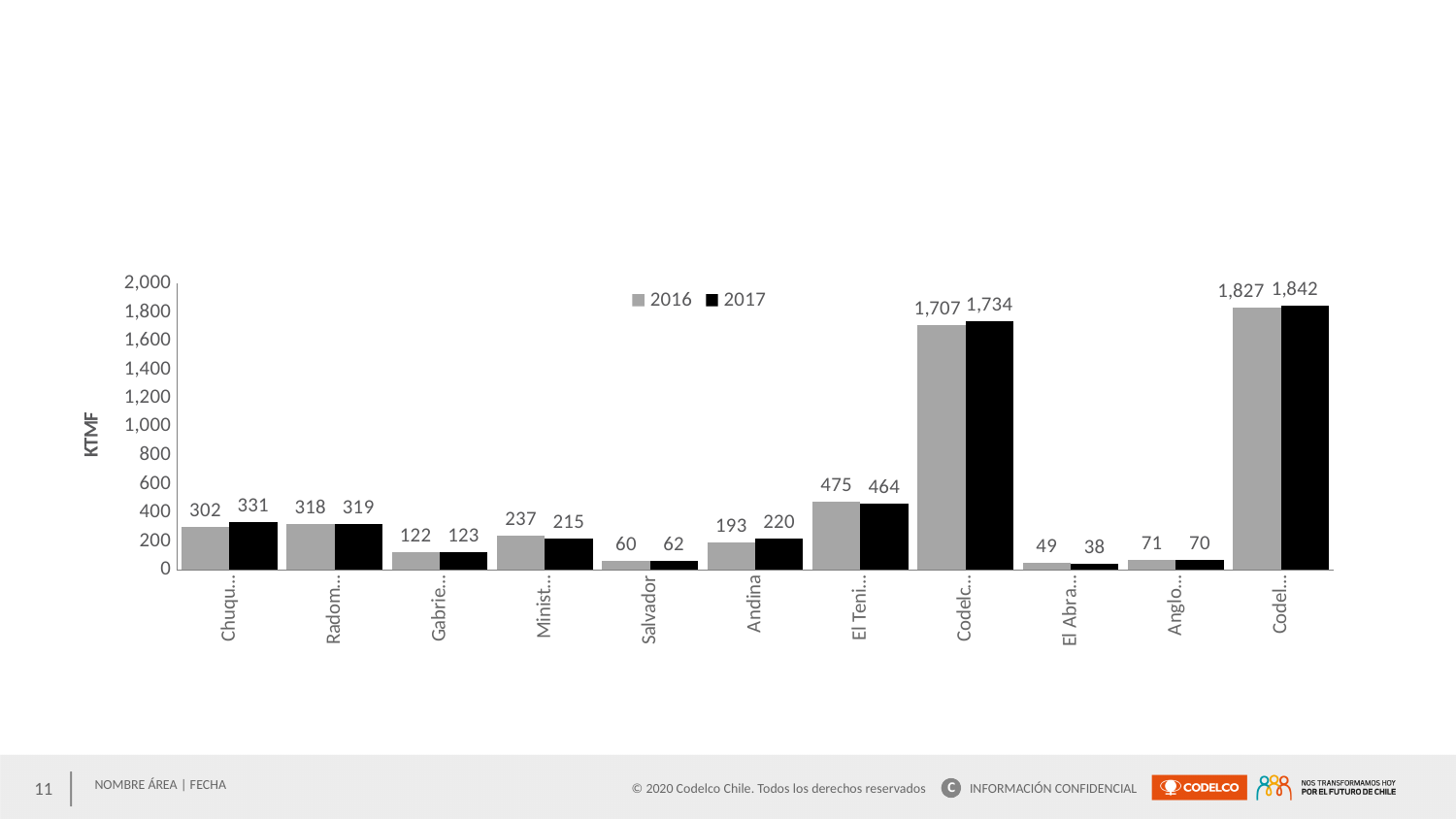
How many categories are shown on the x axis? 11 What is the 2016 value for Andina? 193 What is the 2017 value for Andina? 220 What is the 2016 value for Salvador? 60 By how much did the value for Andina increase from 2016 to 2017? 27 How many series does the legend list? 2 What kind of chart is shown on the slide? bar chart What is the difference between the 2017 and 2016 values for Salvador? 2 What is the highest 2017 value shown on the chart? 1,842 For Salvador, which year has the larger value, 2016 or 2017? 2017 What is the lowest 2017 value shown on the chart? 38 What is the label on the vertical axis? KTMF